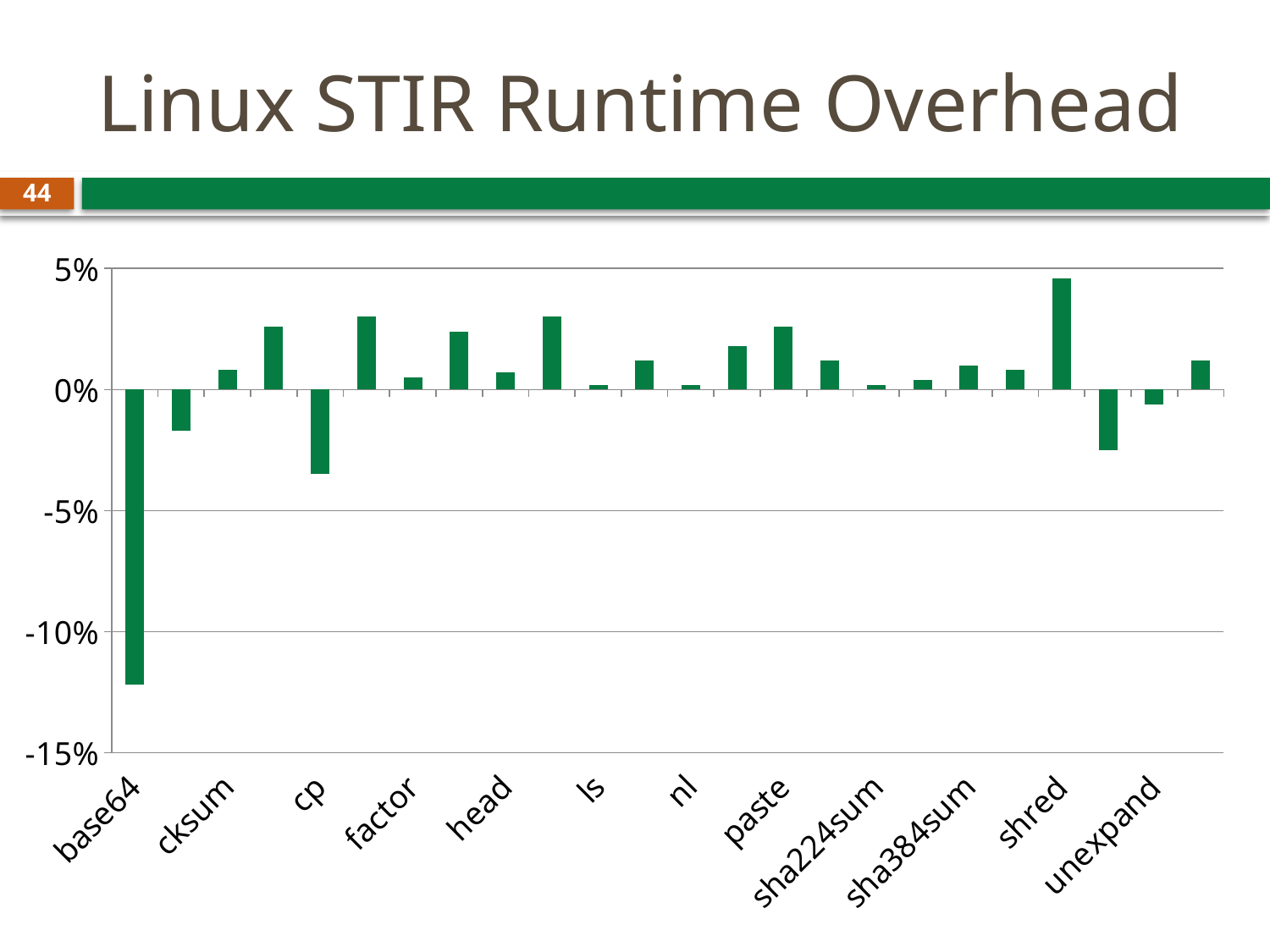
What kind of chart is shown on the slide? bar chart Which has the larger value, shred or paste? shred Is the value for cp greater or less than 0%? less Is the value for base64 greater or less than -10%? less Is the value for cp greater or less than -5%? greater Which labelled program has the lowest runtime overhead in the chart? base64 Which labelled program has the highest runtime overhead in the chart? shred Which has the larger value, base64 or cp? cp What is the title of the chart on the slide? Linux STIR Runtime Overhead